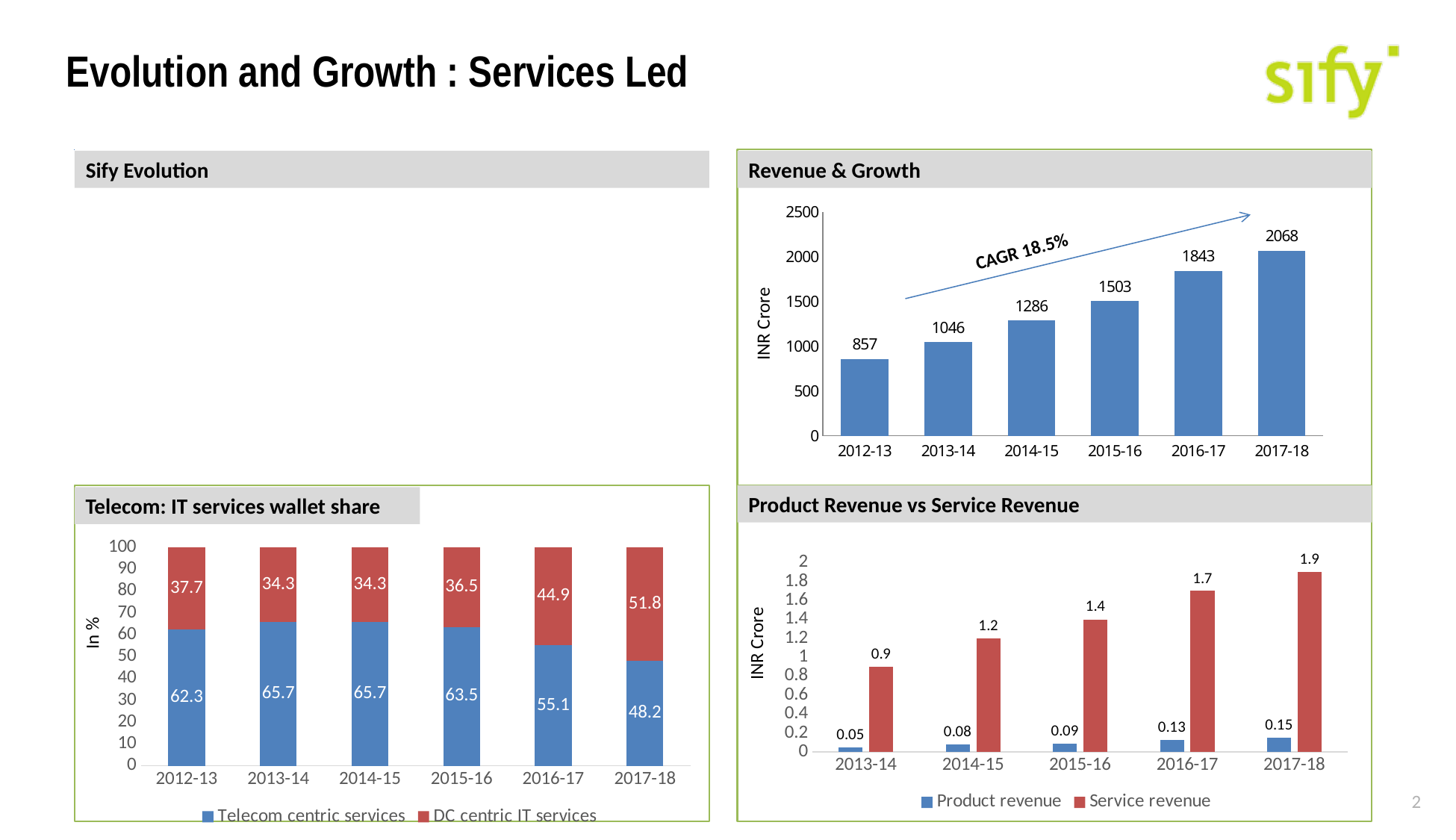
In the Revenue & Growth chart, how many years are plotted? 6 In the Product Revenue vs Service Revenue chart, which is larger in 2014-15: Product revenue or Service revenue? Service revenue In the Telecom: IT services wallet share chart, what is the total of the stacked bar for 2013-14? 100 In the Revenue & Growth chart, which year has the highest revenue? 2017-18 What kind of chart is the Product Revenue vs Service Revenue chart? bar chart In the Revenue & Growth chart, do the values rise or fall from 2012-13 to 2017-18? rise In the Revenue & Growth chart, what is the revenue for 2015-16? 1503 In the Product Revenue vs Service Revenue chart, what is the Product revenue for 2016-17? 0.13 In the Telecom: IT services wallet share chart, how many series does the legend list? 2 In the Telecom: IT services wallet share chart, what is the value for DC centric IT services in 2016-17? 44.9 In the Telecom: IT services wallet share chart, which year has the lowest value for Telecom centric services? 2017-18 In the Revenue & Growth chart, what is the difference between the 2017-18 and 2012-13 values? 1211